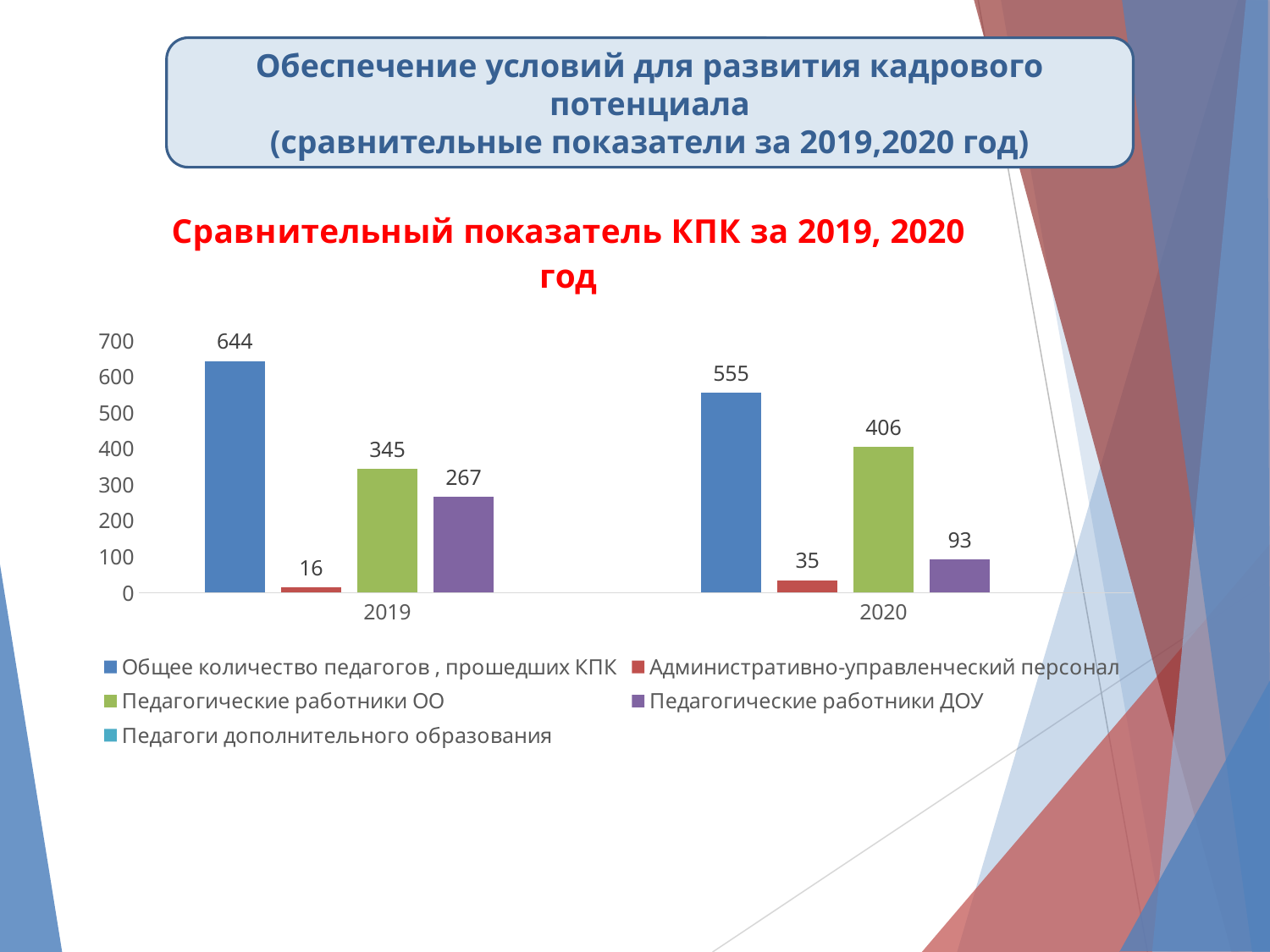
What is the value for Педагогические работники ОО in 2020? 406 What is the value for Административно-управленческий персонал in 2019? 16 Which series has the lowest value in 2019? Административно-управленческий персонал How many year categories are shown on the x axis? 2 Which series has the highest value in 2020? Общее количество педагогов, прошедших КПК How many series does the legend list? 5 What is the value for Общее количество педагогов, прошедших КПК in 2019? 644 Which is larger: Педагогические работники ДОУ in 2019 or in 2020? 2019 What is the title of the chart? Сравнительный показатель КПК за 2019, 2020 год What is the value for Педагогические работники ДОУ in 2020? 93 What is the difference between the values for Общее количество педагогов, прошедших КПК in 2019 and 2020? 89 What kind of chart is shown on the slide? Bar chart